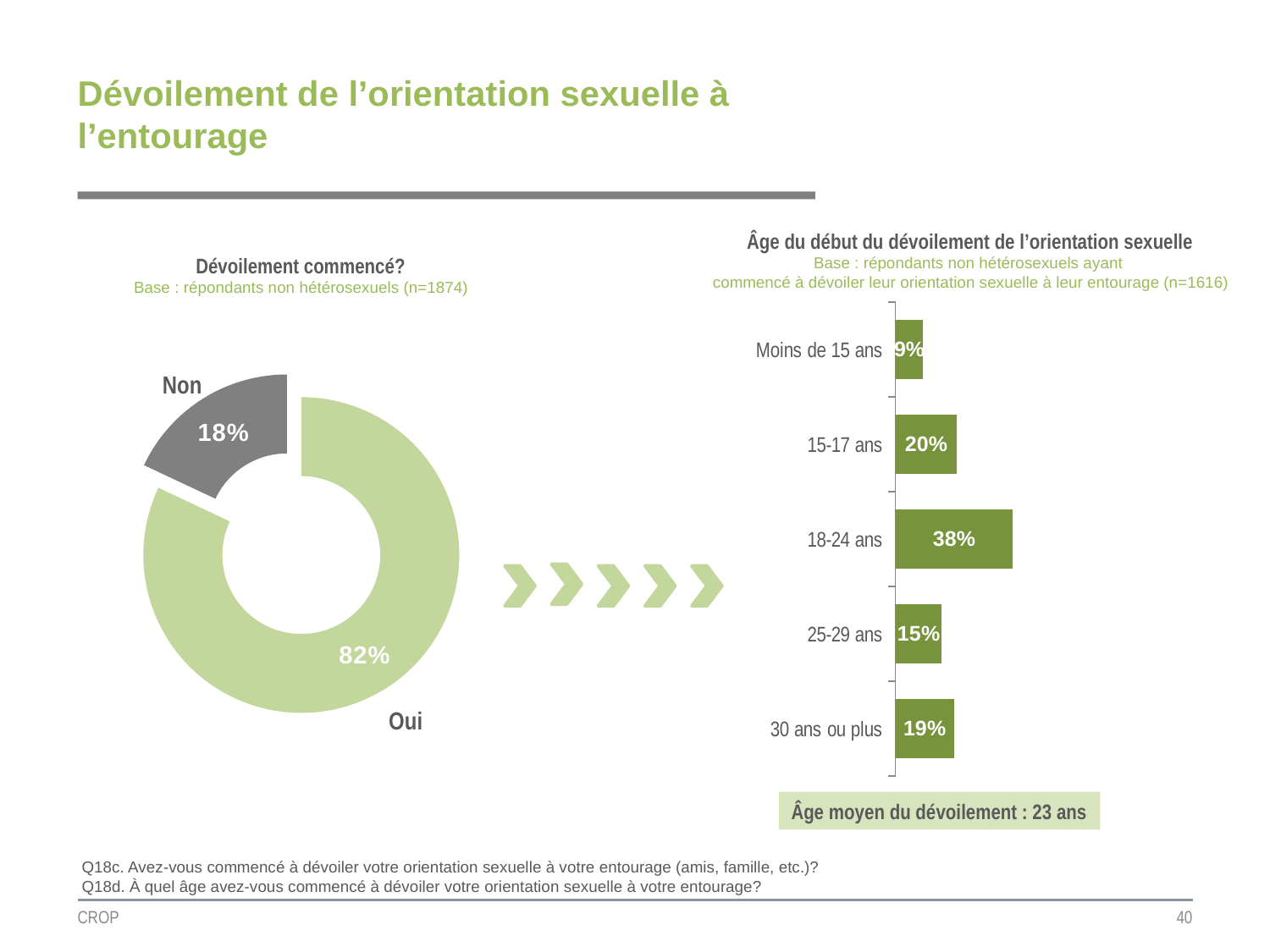
In the 'Âge du début du dévoilement de l'orientation sexuelle' chart, what is the difference between '18-24 ans' and '15-17 ans'? 18 percentage points In the 'Âge du début du dévoilement de l'orientation sexuelle' chart, what is the value for 'Moins de 15 ans'? 9% In the 'Âge du début du dévoilement de l'orientation sexuelle' chart, which is larger: '25-29 ans' or '30 ans ou plus'? 30 ans ou plus In the 'Dévoilement commencé?' chart, what percentage answered 'Oui'? 82% In the 'Dévoilement commencé?' chart, how many slices are shown? 2 In the 'Âge du début du dévoilement de l'orientation sexuelle' chart, what is the value for '18-24 ans'? 38% What kind of chart is the 'Âge du début du dévoilement de l'orientation sexuelle' chart? Bar chart What kind of chart is the 'Dévoilement commencé?' chart? Doughnut chart In the 'Âge du début du dévoilement de l'orientation sexuelle' chart, which age category has the highest value? 18-24 ans In the 'Âge du début du dévoilement de l'orientation sexuelle' chart, how many age categories are shown? 5 In the 'Âge du début du dévoilement de l'orientation sexuelle' chart, which age category has the lowest value? Moins de 15 ans In the 'Dévoilement commencé?' chart, what percentage answered 'Non'? 18%